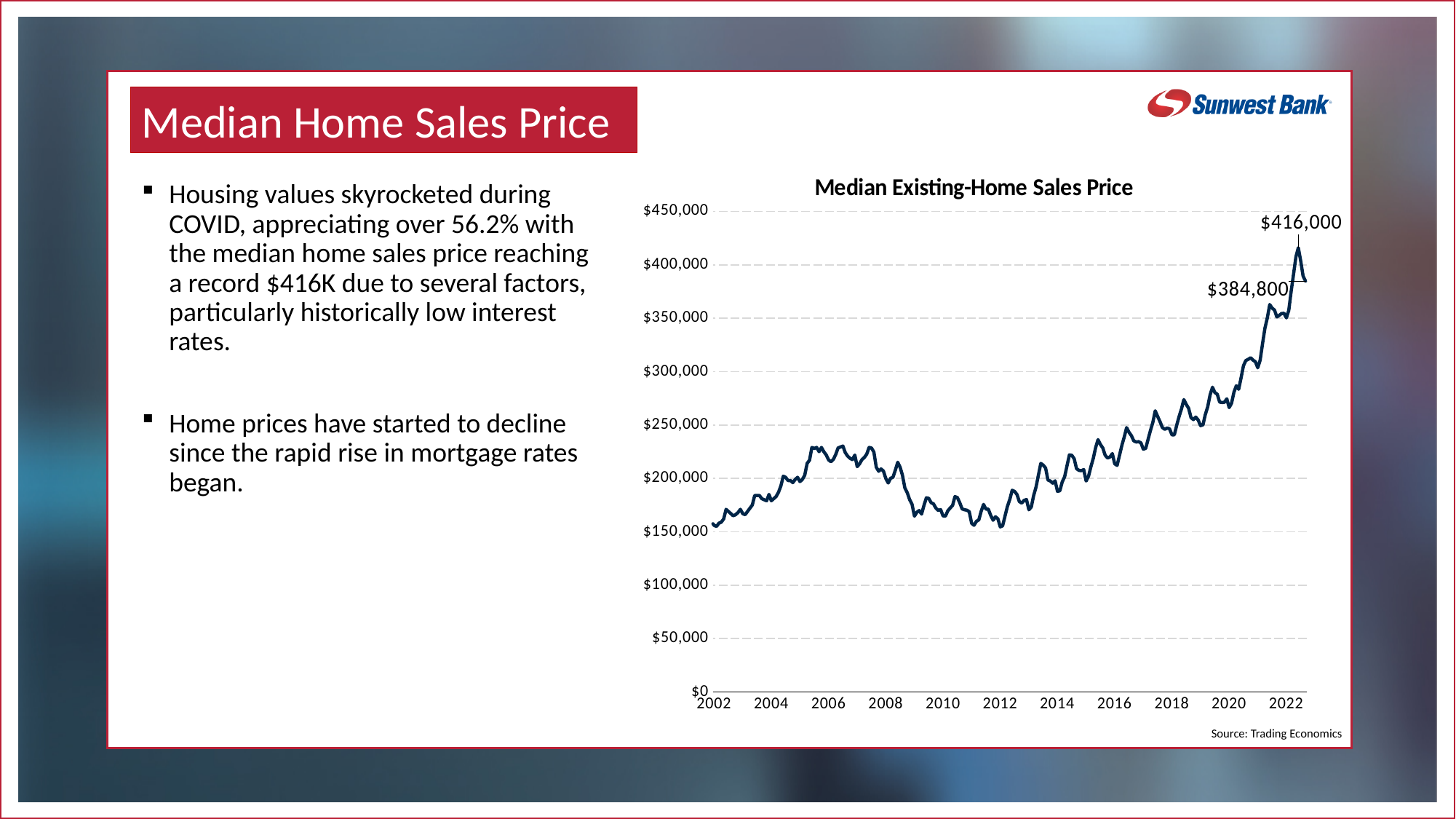
What is the peak value labeled on the chart? $416,000 What is the difference between the labeled peak value of $416,000 and the labeled value of $384,800? $31,200 What source is cited for the chart? Trading Economics Which of the two labeled values is larger, $416,000 or $384,800? $416,000 Overall, does the median home sales price rise or fall from 2002 to 2022? rise What is the title of the chart? Median Existing-Home Sales Price Is the median home sales price in 2012 greater or less than $200,000? less What kind of chart is shown on the slide? line chart What is the most recent value labeled on the chart, after the peak? $384,800 Is the median home sales price in 2002 greater or less than $200,000? less Is the median home sales price in 2020 greater or less than $250,000? greater